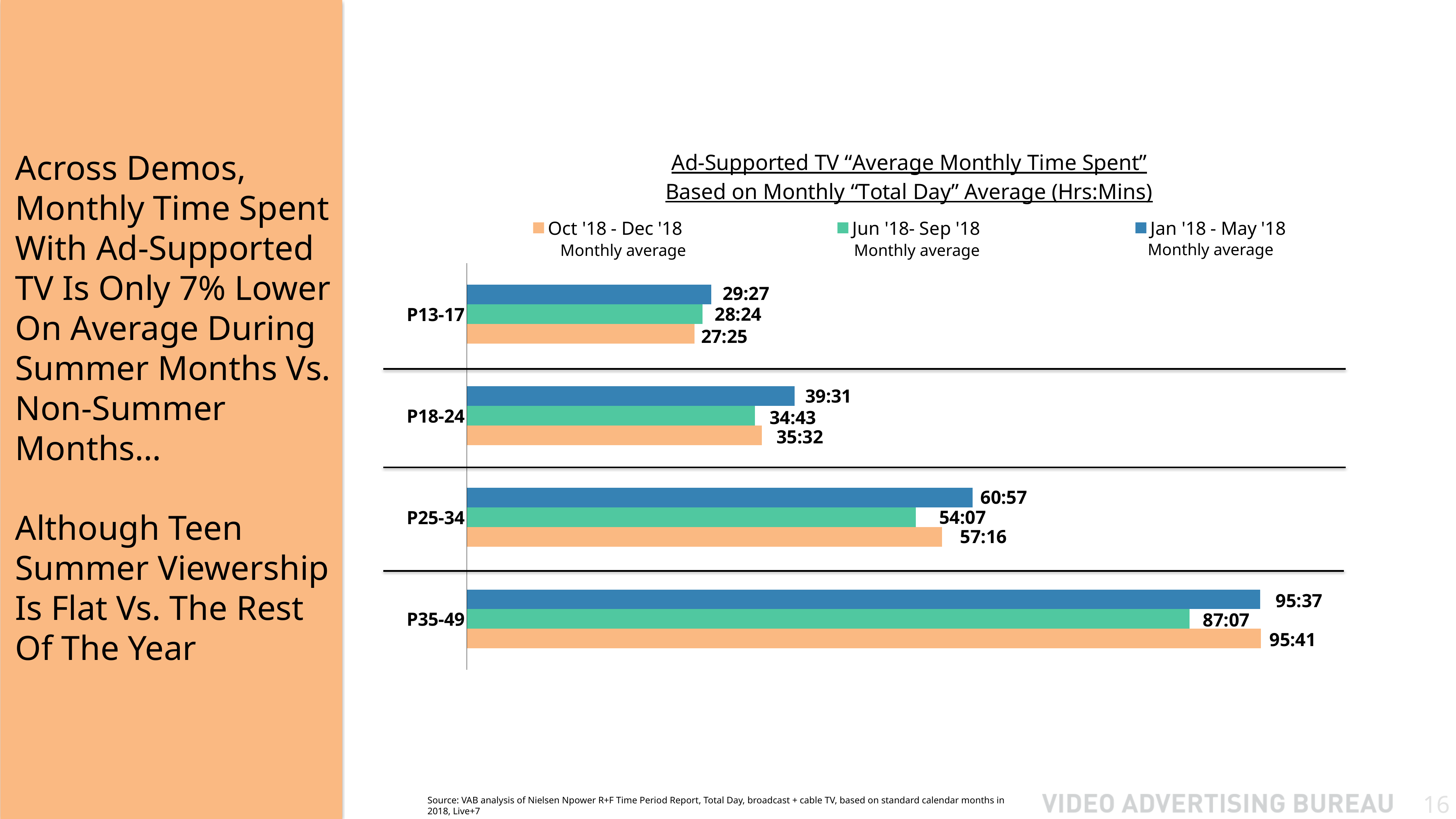
How many demographic categories are plotted on the chart? 4 What is the Jan '18 - May '18 monthly average for P13-17? 29:27 For P25-34, which is larger: the Jan '18 - May '18 average or the Jun '18 - Sep '18 average? Jan '18 - May '18 What kind of chart is shown on the slide? Bar chart What is the Oct '18 - Dec '18 monthly average for P18-24? 35:32 What is the Oct '18 - Dec '18 monthly average for P35-49? 95:41 Which colour represents the Jun '18 - Sep '18 monthly average series? Green What is the Jun '18 - Sep '18 monthly average for P25-34? 54:07 What is the difference between the Jan '18 - May '18 and Jun '18 - Sep '18 monthly averages for P35-49? 8:30 Which demographic has the lowest Jun '18 - Sep '18 monthly average? P13-17 How many series does the legend list? 3 Which demographic has the highest Jan '18 - May '18 monthly average? P35-49